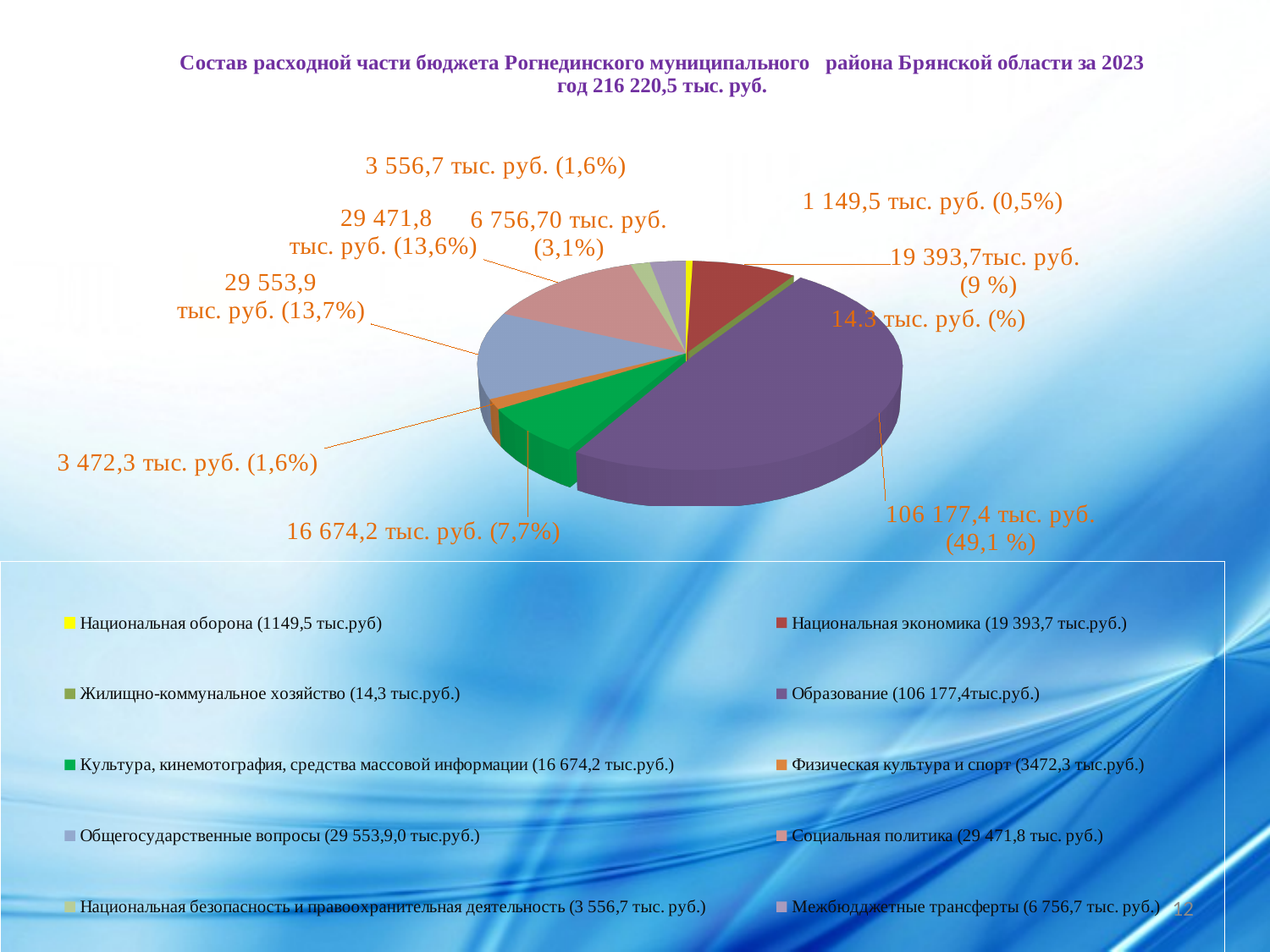
Which category has the smallest slice of the pie chart? Жилищно-коммунальное хозяйство How many categories (slices) does the legend of the pie chart list? 10 What percentage is shown for Национальная оборона? 0,5% What is the value shown for Культура, кинемотография, средства массовой информации? 16 674,2 тыс. руб. According to the slide title, what is the total expenditure of the budget for 2023? 216 220,5 тыс. руб. What kind of chart is shown on the slide? pie chart What is the value shown for Национальная экономика? 19 393,7 тыс. руб. What share of the pie does Образование account for, according to its data label? 49,1 % Which category has the largest slice of the pie chart? Образование What is the difference between the value for Национальная экономика (19 393,7 тыс. руб.) and the value for Культура, кинемотография, средства массовой информации (16 674,2 тыс. руб.)? 2 719,5 тыс. руб. What percentage is shown for Социальная политика? 13,6% Which is larger: the value for Общегосударственные вопросы or the value for Социальная политика? Общегосударственные вопросы